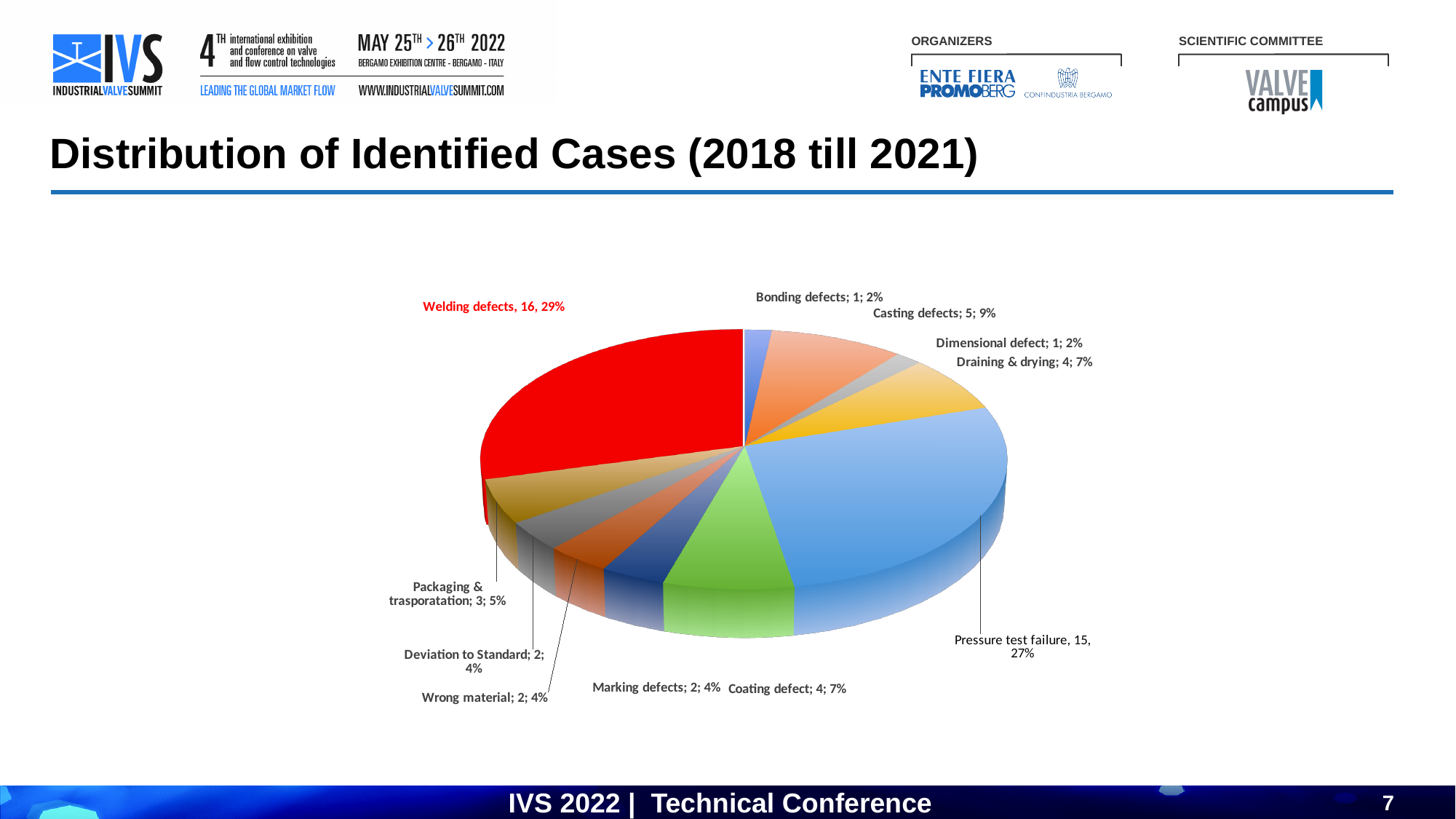
How many cases are attributed to Casting defects? 5 What is the difference in number of cases between Welding defects and Pressure test failure? 1 How many categories are shown in the pie chart? 11 Which category has the largest share of the pie chart? Welding defects What is the title of the slide containing the pie chart? Distribution of Identified Cases (2018 till 2021) How many cases are attributed to Welding defects? 16 What percentage share does Packaging & trasporatation have? 5% What type of chart is shown on the slide? Pie chart Which category's label is shown in red text on the chart? Welding defects How many cases are attributed to Coating defect? 4 What percentage share does Pressure test failure have in the pie chart? 27% Which has more cases, Casting defects or Draining & drying? Casting defects